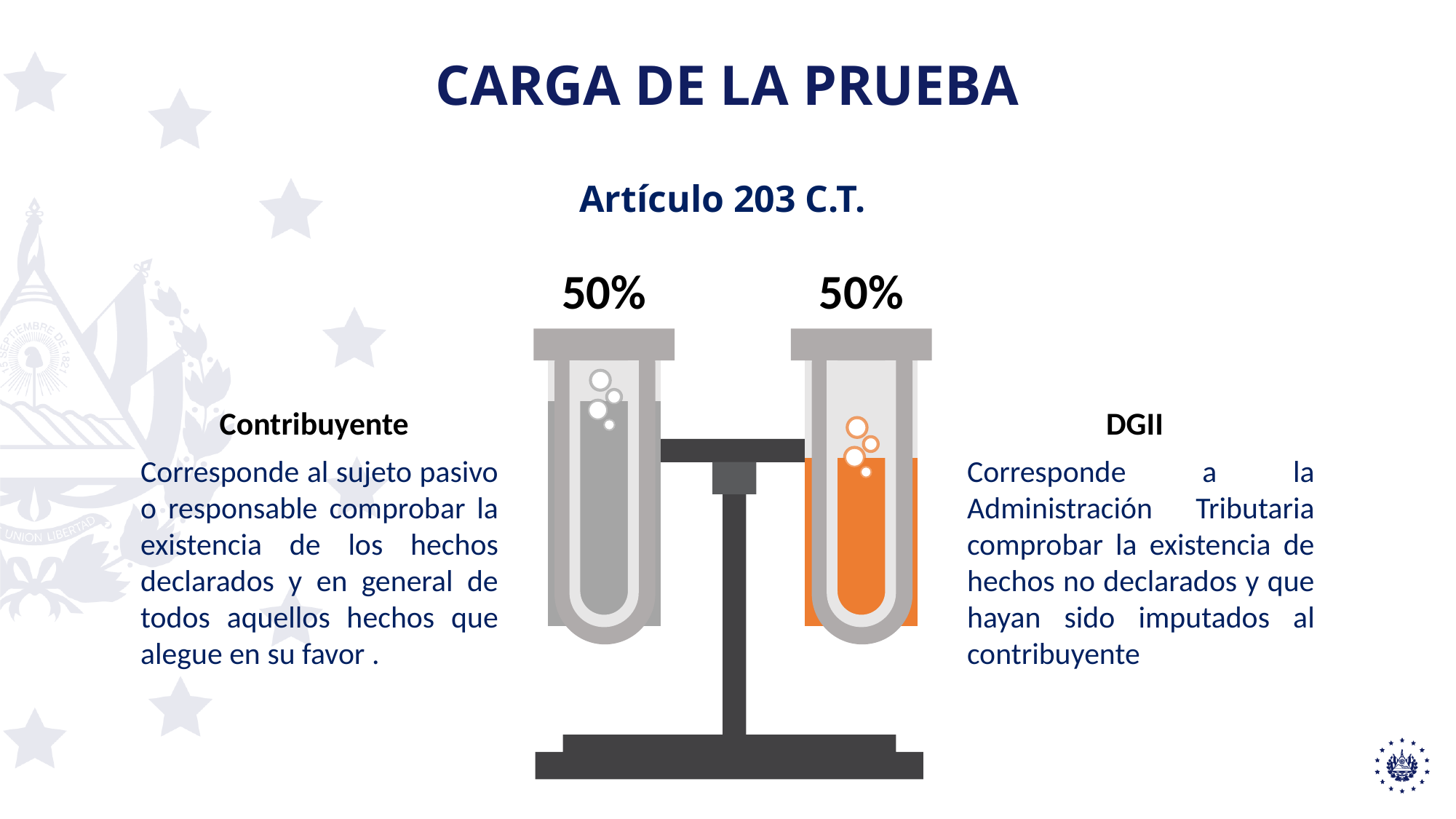
How many parties are shown with a percentage in the graphic? 2 What is the title of the slide containing the graphic? CARGA DE LA PRUEBA Is the share shown for Contribuyente larger, smaller, or equal to the share shown for DGII? equal What is the total of the two percentages shown in the graphic? 100% What is the difference between the percentage for DGII and the percentage for Contribuyente? 0% What percentage is shown for Contribuyente? 50% Which article is cited above the graphic? Artículo 203 C.T. What percentage is shown for DGII? 50%